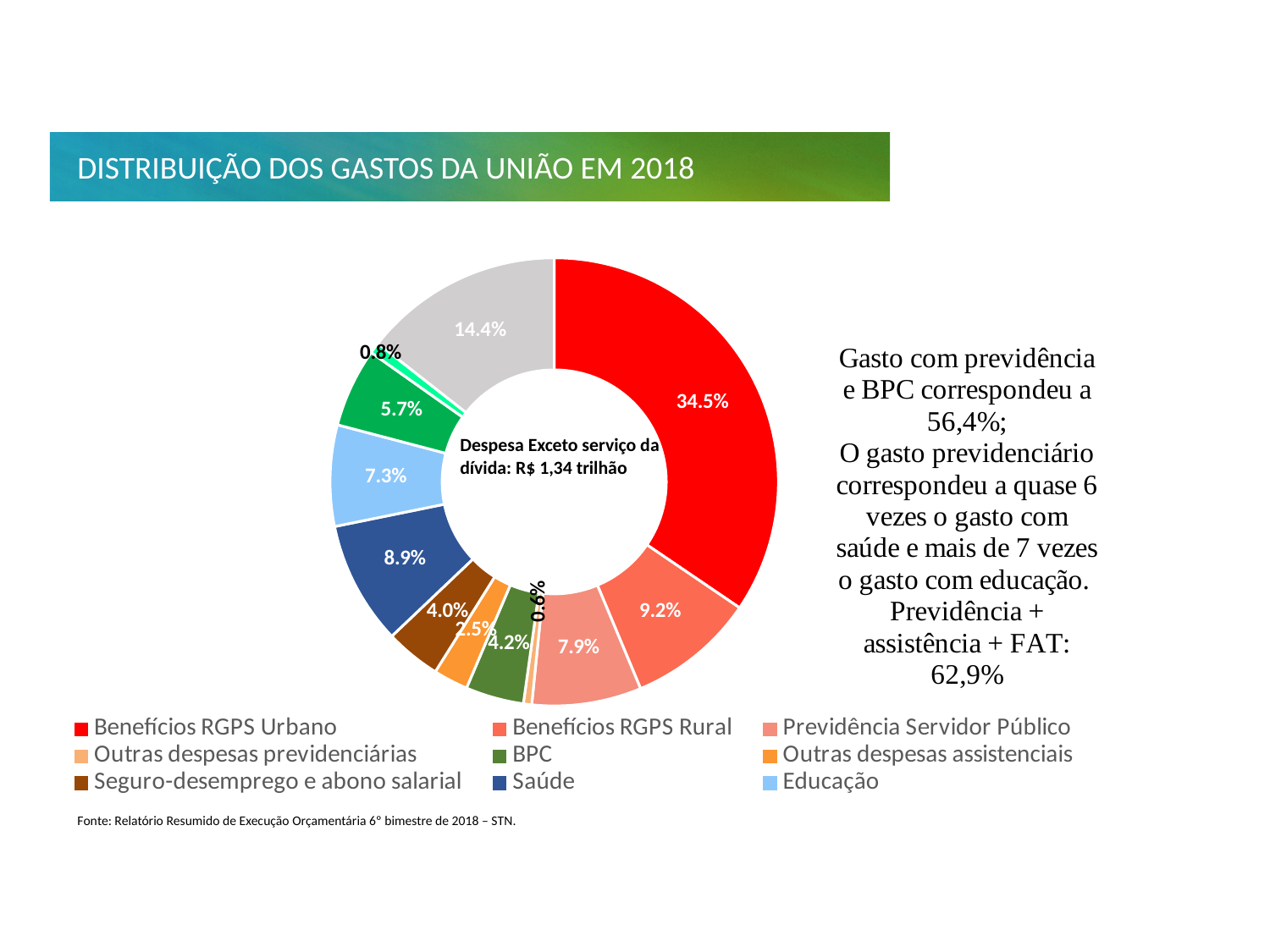
What share of the pie does Benefícios RGPS Urbano represent? 34.5% What is the value shown for BPC? 4.2% What is the difference between the values for Saúde and Educação? 1.6% What is the value shown for Saúde? 8.9% What is the value shown for Educação? 7.3% Which legend category has the smallest slice of the chart? Outras despesas previdenciárias What kind of chart is shown on the slide? Pie (doughnut) chart What total expenditure is stated in the centre of the chart? R$ 1,34 trilhão Which is larger, the slice for Benefícios RGPS Rural or the slice for Previdência Servidor Público? Benefícios RGPS Rural How many entries does the chart legend list? 9 What is the value shown for Benefícios RGPS Rural? 9.2% Which category has the largest slice of the chart? Benefícios RGPS Urbano